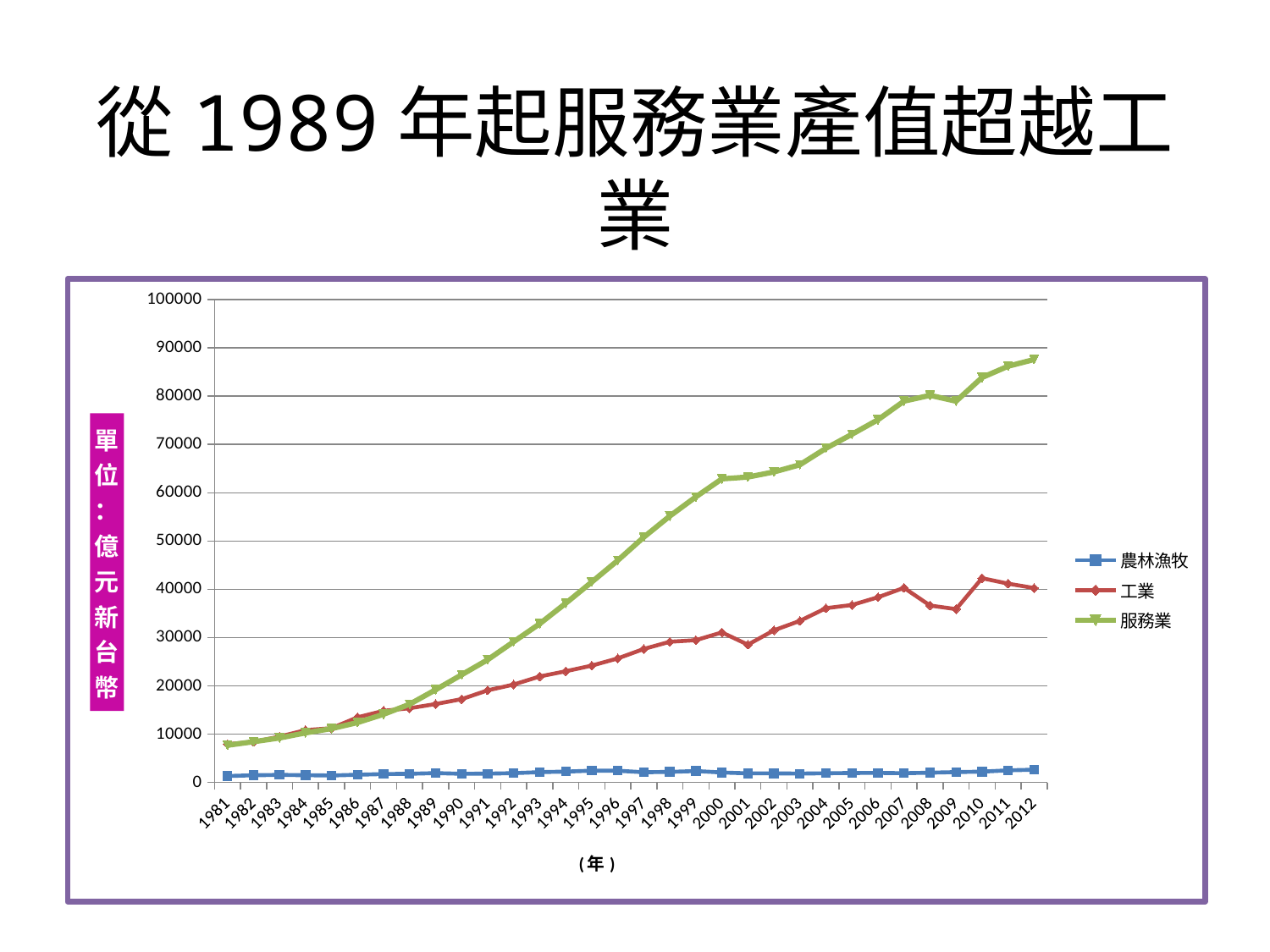
Is the value for 服務業 in 2012 greater or less than 80000? greater What kind of chart is shown on the slide? line chart Is the value for 工業 in 2012 greater or less than 50000? less How many series does the legend list? 3 Which series has the lowest value in 2012? 農林漁牧 Is the value for 農林漁牧 in 2000 greater or less than 10000? less Does the value for 服務業 generally rise or fall from 1981 to 2012? rise Which series has the highest value in 2012? 服務業 Which is larger in 2005, the value for 工業 or the value for 服務業? 服務業 How many years are plotted along the x axis? 32 What unit is given for the values on the chart? 億元新台幣